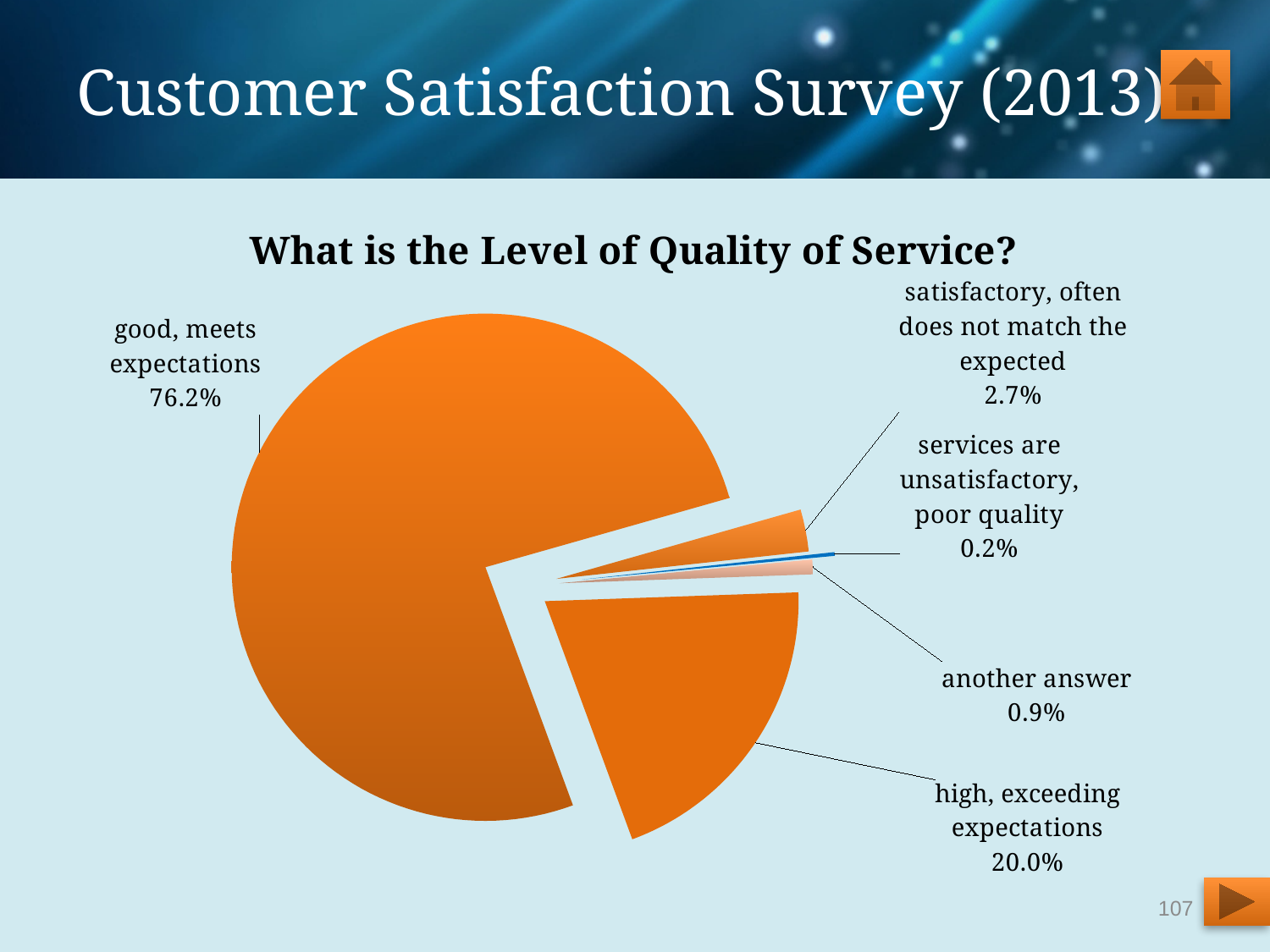
What share of responses is "satisfactory, often does not match the expected"? 2.7% What type of chart is shown on the slide? pie chart What share of responses is "services are unsatisfactory, poor quality"? 0.2% What share of responses is "another answer"? 0.9% What is the title of the chart? What is the Level of Quality of Service? What share of responses is "high, exceeding expectations"? 20.0% Which category has the smallest share of the pie? services are unsatisfactory, poor quality What is the difference between the shares for "good, meets expectations" and "high, exceeding expectations"? 56.2% How many categories are shown in the pie chart? 5 Which category has the largest share of the pie? good, meets expectations Which is larger: the share for "satisfactory, often does not match the expected" or the share for "another answer"? satisfactory, often does not match the expected What share of responses is "good, meets expectations"? 76.2%